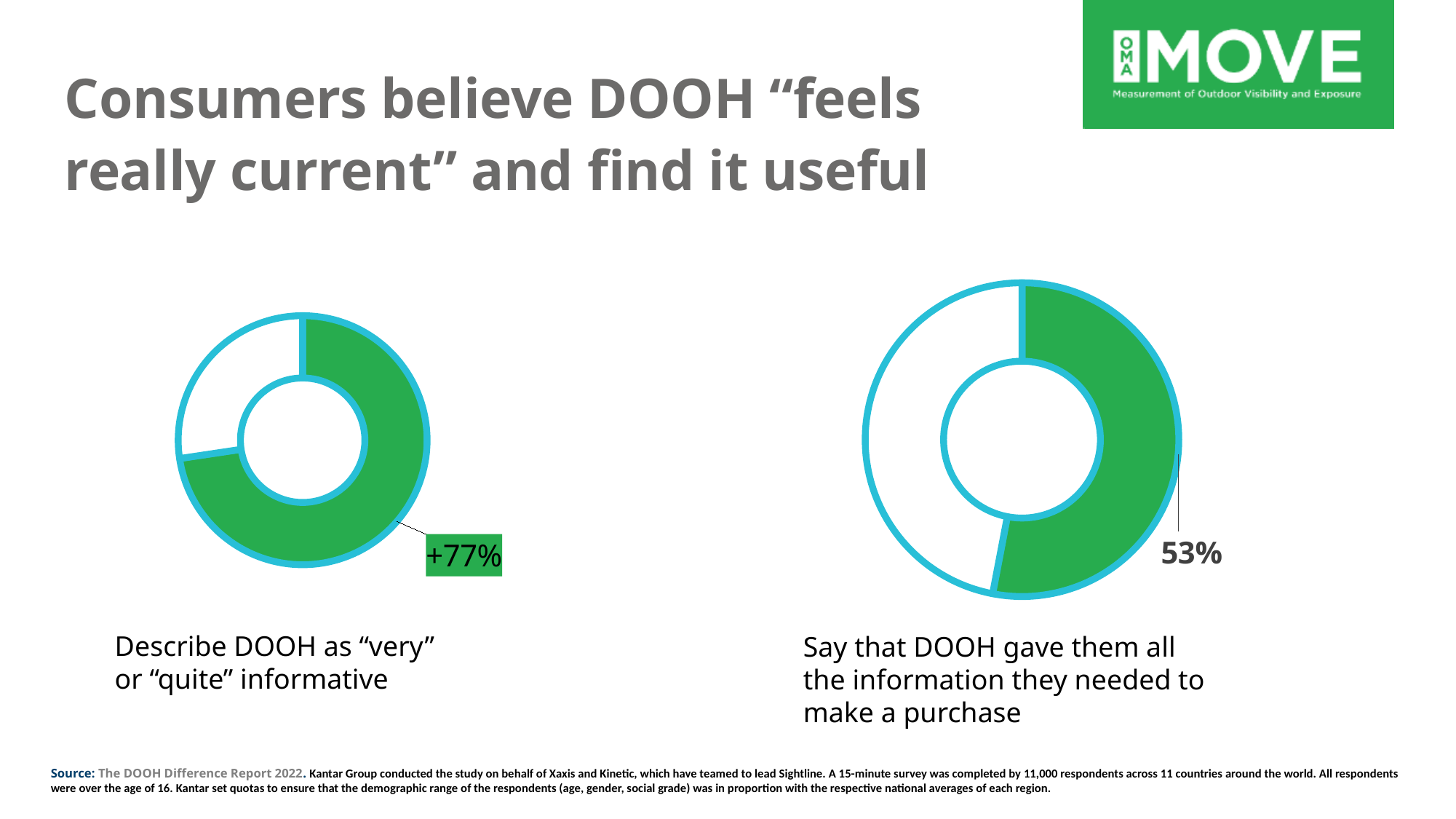
On the right donut chart, what percentage of consumers say that DOOH gave them all the information they needed to make a purchase? 53% What kind of chart is used on the right side of the slide? Donut chart On the right donut chart, what share of the ring is filled green? 53% What is the caption below the right donut chart? Say that DOOH gave them all the information they needed to make a purchase What kind of chart is used on the left side of the slide? Donut chart On the right donut chart, is the green segment more or less than half of the ring? More How many donut charts are shown on the slide? 2 Which is larger: the share describing DOOH as informative (left chart) or the share saying DOOH gave them all the information needed to make a purchase (right chart)? Describe DOOH as "very" or "quite" informative (left chart) On the left donut chart, what percentage of consumers describe DOOH as "very" or "quite" informative? +77% What is the difference in percentage points between the left chart's value (+77%) and the right chart's value (53%)? 24 percentage points What colour is used for the highlighted segment in both donut charts? Green On the left donut chart, what share of the ring is filled green? +77%